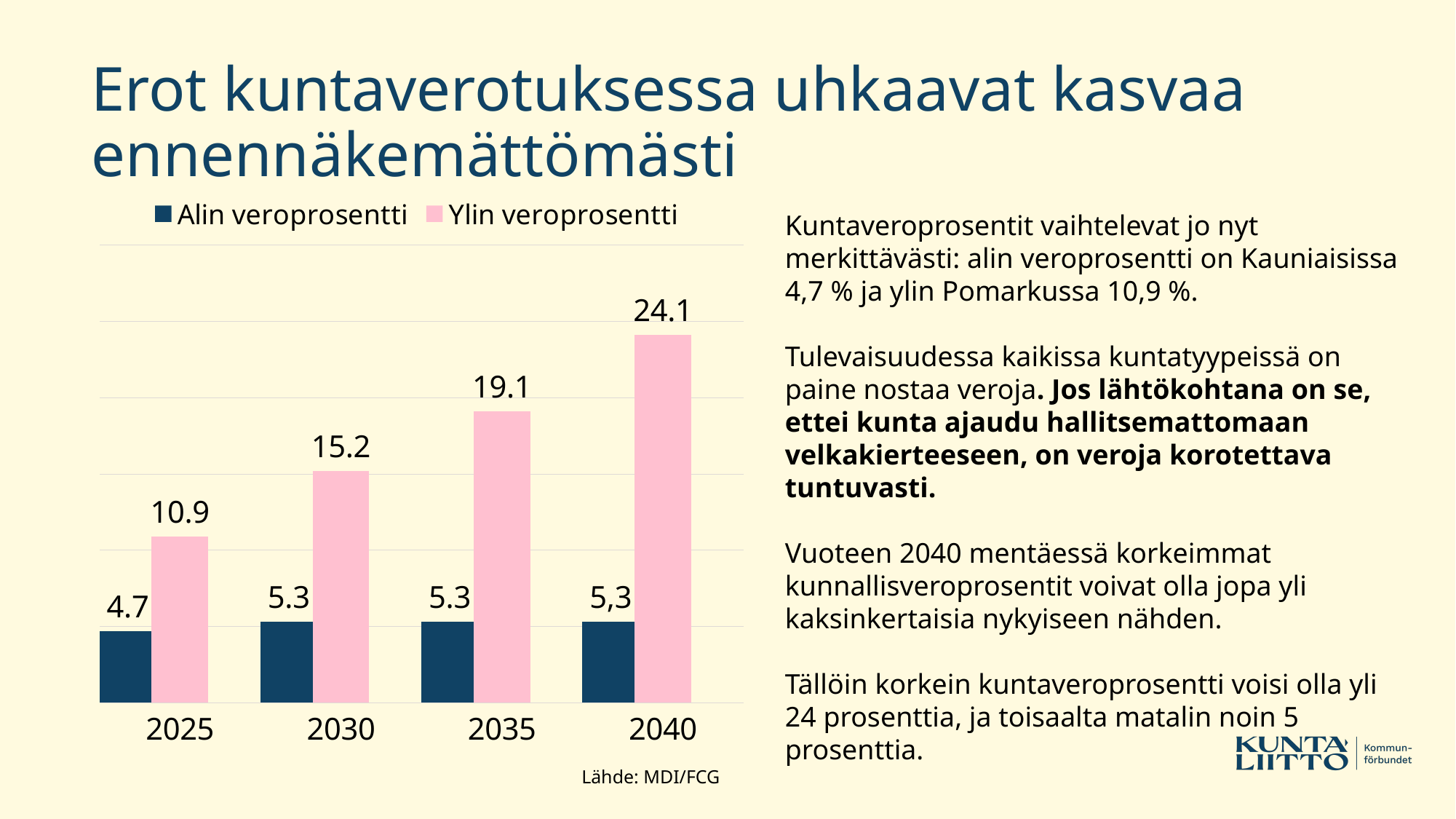
Does Ylin veroprosentti rise or fall from 2025 to 2040? rise What is the value of Ylin veroprosentti for 2030? 15.2 What is the value of Ylin veroprosentti for 2040? 24.1 By how much does Ylin veroprosentti increase from 2025 to 2040? 13.2 What is the value of Alin veroprosentti for 2025? 4.7 How many series does the chart legend list? 2 In which year is Ylin veroprosentti highest? 2040 In which year is Ylin veroprosentti lowest? 2025 What is the difference between Ylin veroprosentti and Alin veroprosentti in 2040? 18.8 How many years are shown on the x axis of the chart? 4 What is the value of Alin veroprosentti for 2035? 5.3 Which is larger: Ylin veroprosentti in 2035 or Ylin veroprosentti in 2030? Ylin veroprosentti in 2035